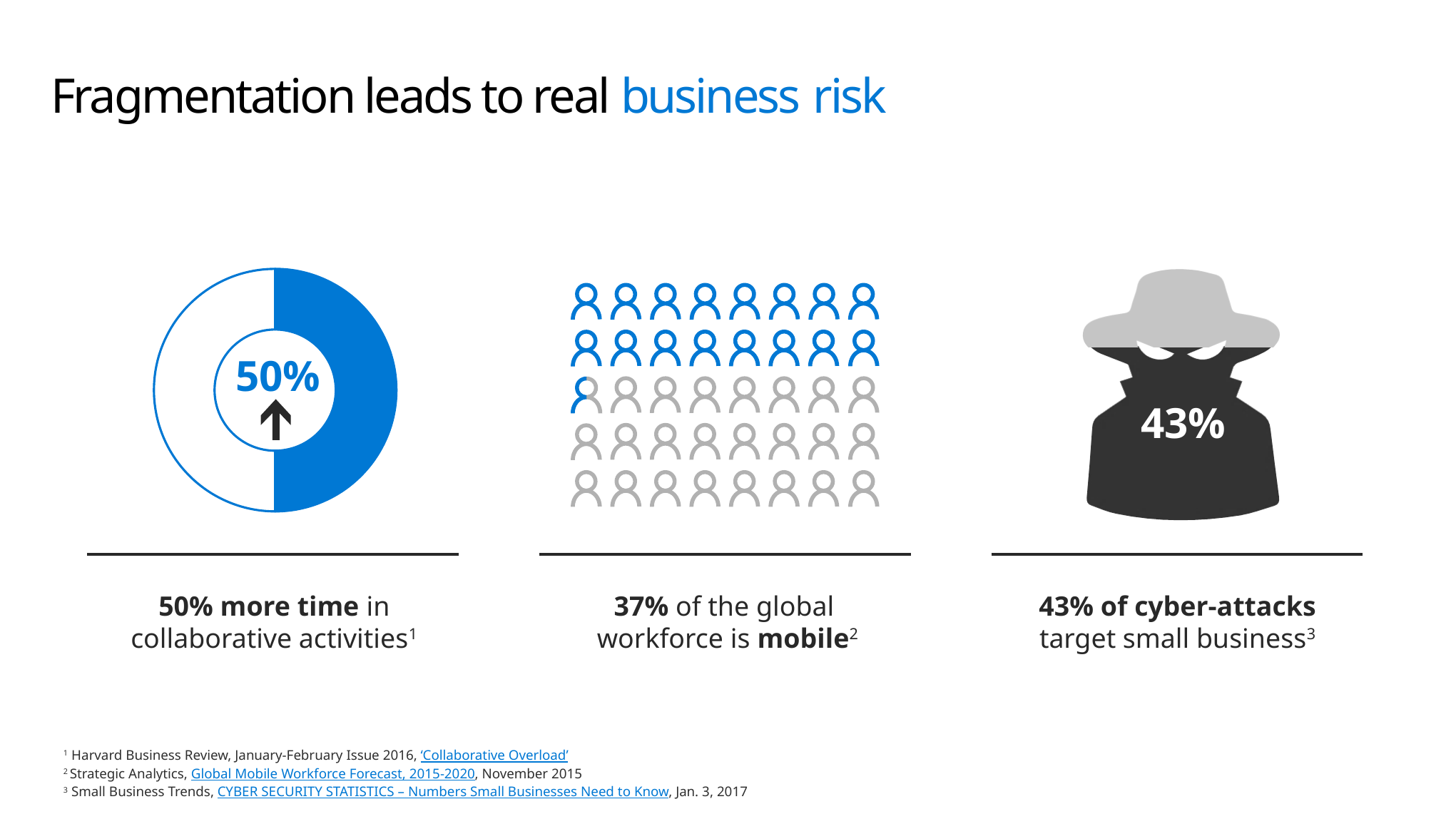
What is the difference between the cyber-attacks percentage (43%) and the mobile workforce percentage (37%)? 6 percentage points How many person icons are in each row of the middle pictogram? 8 How many person icons in total are in the middle pictogram? 40 How many rows of person icons does the middle pictogram have? 5 What value is printed in the centre of the donut chart on the left of the slide? 50% Of the three statistics shown on the slide, which is the smallest? 37% of the global workforce is mobile Which is larger: the share of cyber-attacks targeting small business or the share of the global workforce that is mobile? Cyber-attacks targeting small business (43%) What colour is the filled half of the donut chart on the left? Blue Of the three statistics shown on the slide, which is the largest? 50% more time in collaborative activities What percentage is printed on the spy figure on the right of the slide? 43% What kind of chart is the graphic on the left of the slide showing 50%? Donut (pie) chart According to the middle pictogram, what percentage of the global workforce is mobile? 37%